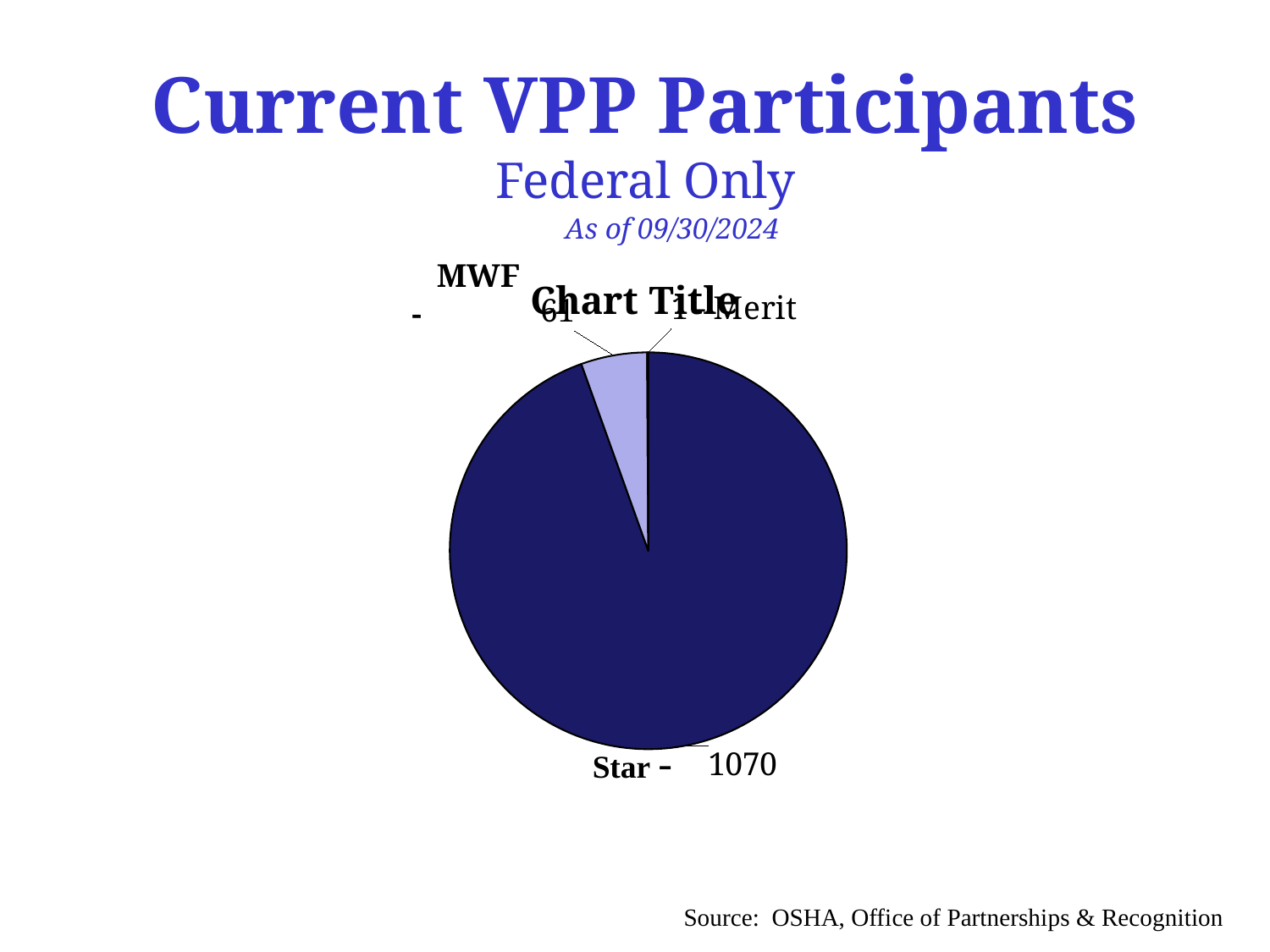
Which category has the largest slice of the pie? Star What is the main title of the slide? Current VPP Participants As of what date is the data on the slide reported? 09/30/2024 What kind of chart is shown on the slide? Pie chart What is the value shown for the Star slice? 1070 What is the value shown for the MWF slice? 61 How many categories are shown in the pie chart? 3 Which is larger, the value for Star or the value for MWF? Star What is the difference between the Star value and the MWF value? 1009 Which category has the smallest slice of the pie? Merit